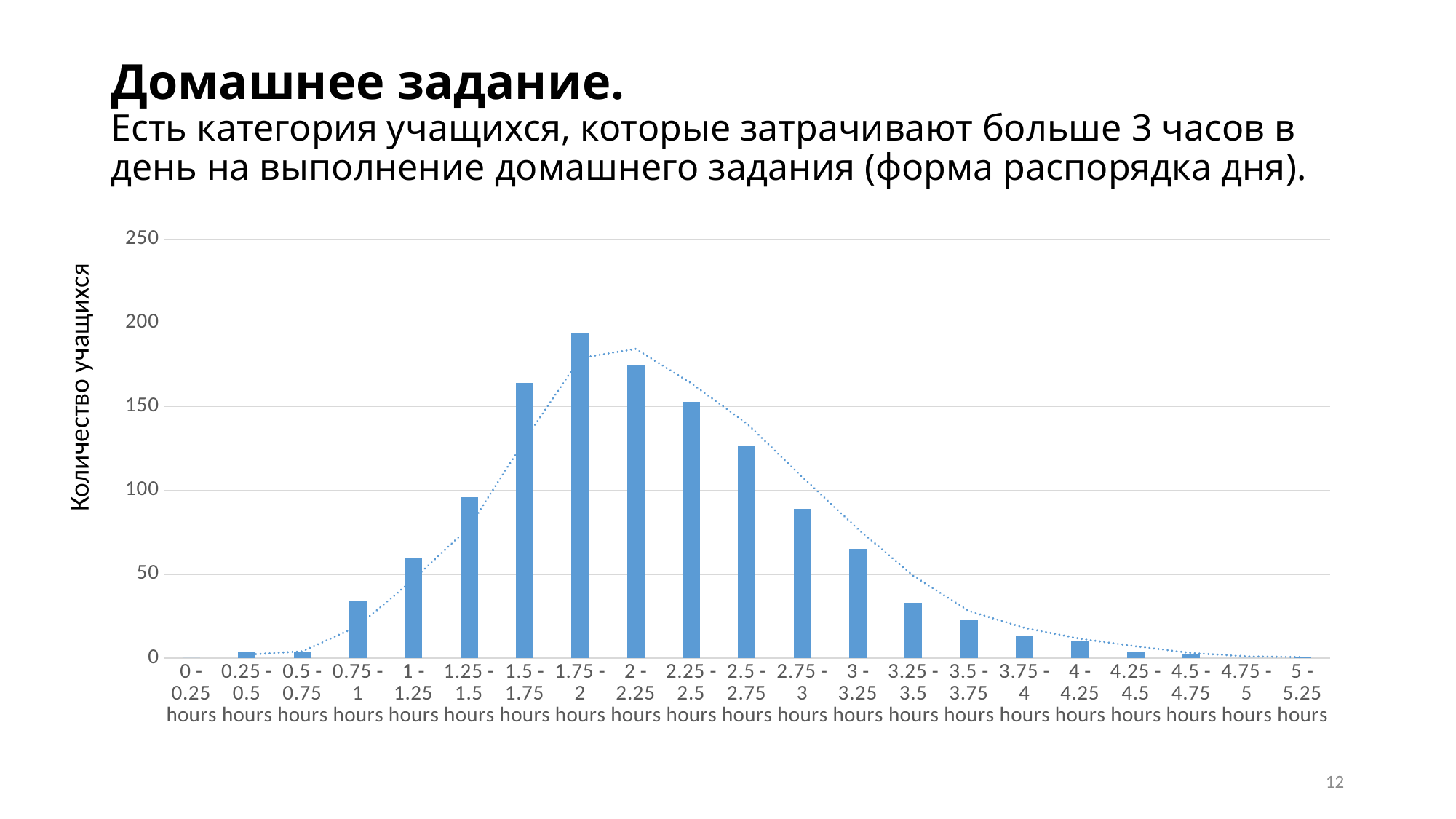
Is the value for 2.75 - 3 hours greater or less than 100? less Which is larger, the value for 1.5 - 1.75 hours or the value for 2.25 - 2.5 hours? 1.5 - 1.75 hours Is the value for 3 - 3.25 hours greater or less than 50? greater Is the value for 1.75 - 2 hours greater or less than 150? greater Which time interval has the highest number of students? 1.75 - 2 hours How many categories (time intervals) are shown on the x axis? 21 What is the title of the vertical axis? Количество учащихся Which is larger, the value for 2 - 2.25 hours or the value for 2.5 - 2.75 hours? 2 - 2.25 hours Do the values rise or fall along the x axis from 2 - 2.25 hours to 4 - 4.25 hours? fall What kind of chart is shown on the slide? bar chart